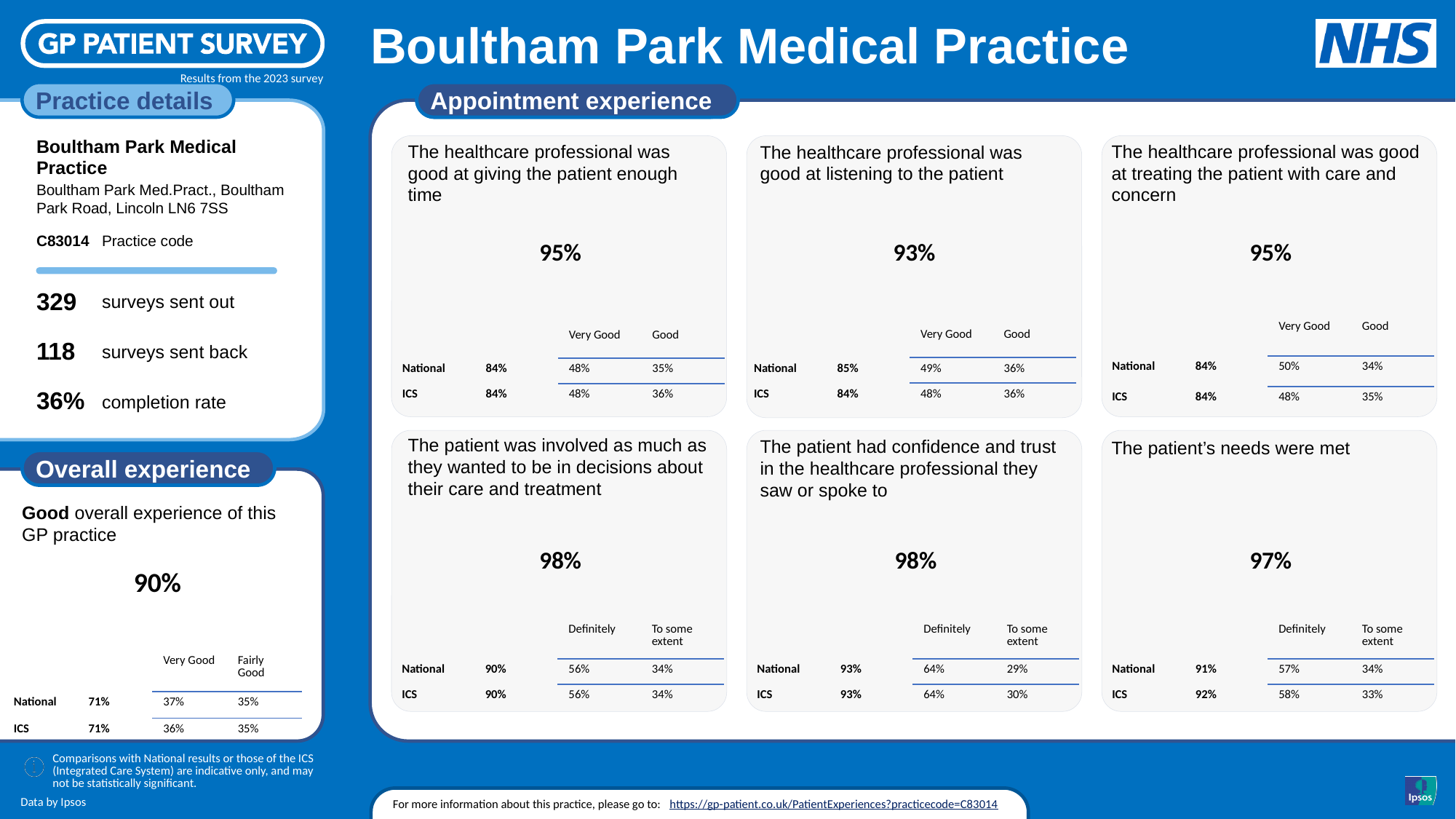
In the 'Overall experience' panel, what is the difference between the practice's 90% and the National 71%? 19 percentage points In the 'Appointment experience' section, what is the highest practice percentage shown across the six questions? 98% How many question panels are shown in the 'Appointment experience' section? 6 In the 'Appointment experience' section, for 'The healthcare professional was good at treating the patient with care and concern', is the National 'Very Good' percentage larger or smaller than the ICS 'Very Good' percentage? larger In the 'Overall experience' panel, what is the National 'Very Good' percentage? 37% In the 'Appointment experience' section, for 'The patient had confidence and trust in the healthcare professional they saw or spoke to', what is the difference between the practice's percentage and the National percentage? 5 percentage points In the 'Practice details' panel, what is the completion rate? 36% In the 'Appointment experience' section, what are the two response categories shown in the table for 'The patient was involved as much as they wanted to be in decisions about their care and treatment'? Definitely, To some extent In the 'Appointment experience' section, what is the practice's percentage for 'The healthcare professional was good at listening to the patient'? 93% In the 'Overall experience' panel, what percentage of patients reported a good overall experience of this GP practice? 90% In the 'Appointment experience' section, what is the ICS 'To some extent' percentage for 'The patient's needs were met'? 33% In the 'Appointment experience' section, which question has the lowest practice percentage? The healthcare professional was good at listening to the patient